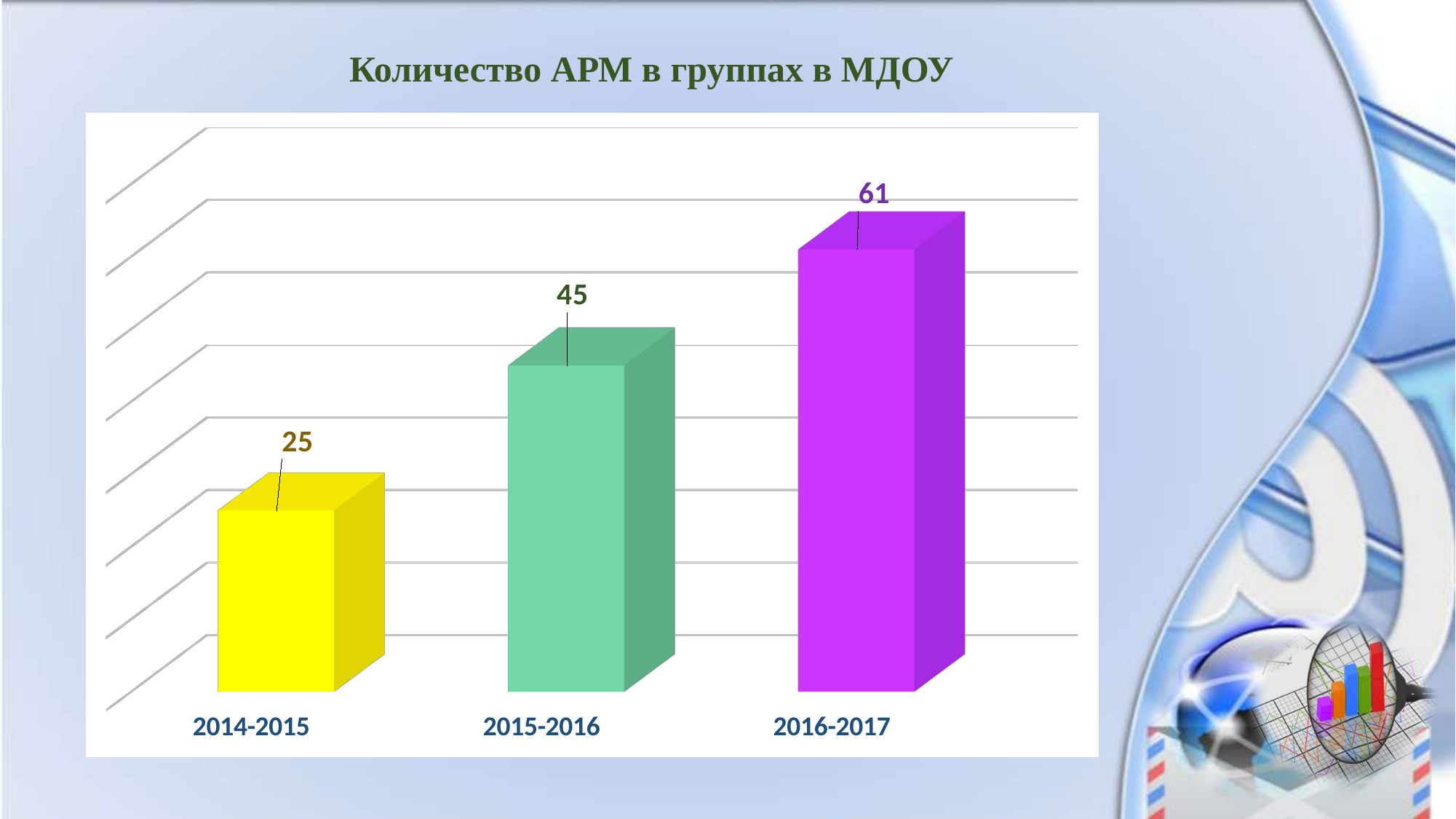
Which period has the highest value? 2016-2017 Which period has the lowest value? 2014-2015 Which is larger, the value for 2015-2016 or the value for 2016-2017? 2016-2017 How many periods are shown on the chart? 3 What is the value for 2014-2015? 25 What is the value for 2016-2017? 61 Do the values rise or fall from 2014-2015 to 2016-2017? rise What is the title of the chart? Количество АРМ в группах в МДОУ What is the value for 2015-2016? 45 What kind of chart is shown on the slide? bar chart What is the difference between the values for 2015-2016 and 2014-2015? 20 What is the difference between the values for 2016-2017 and 2014-2015? 36